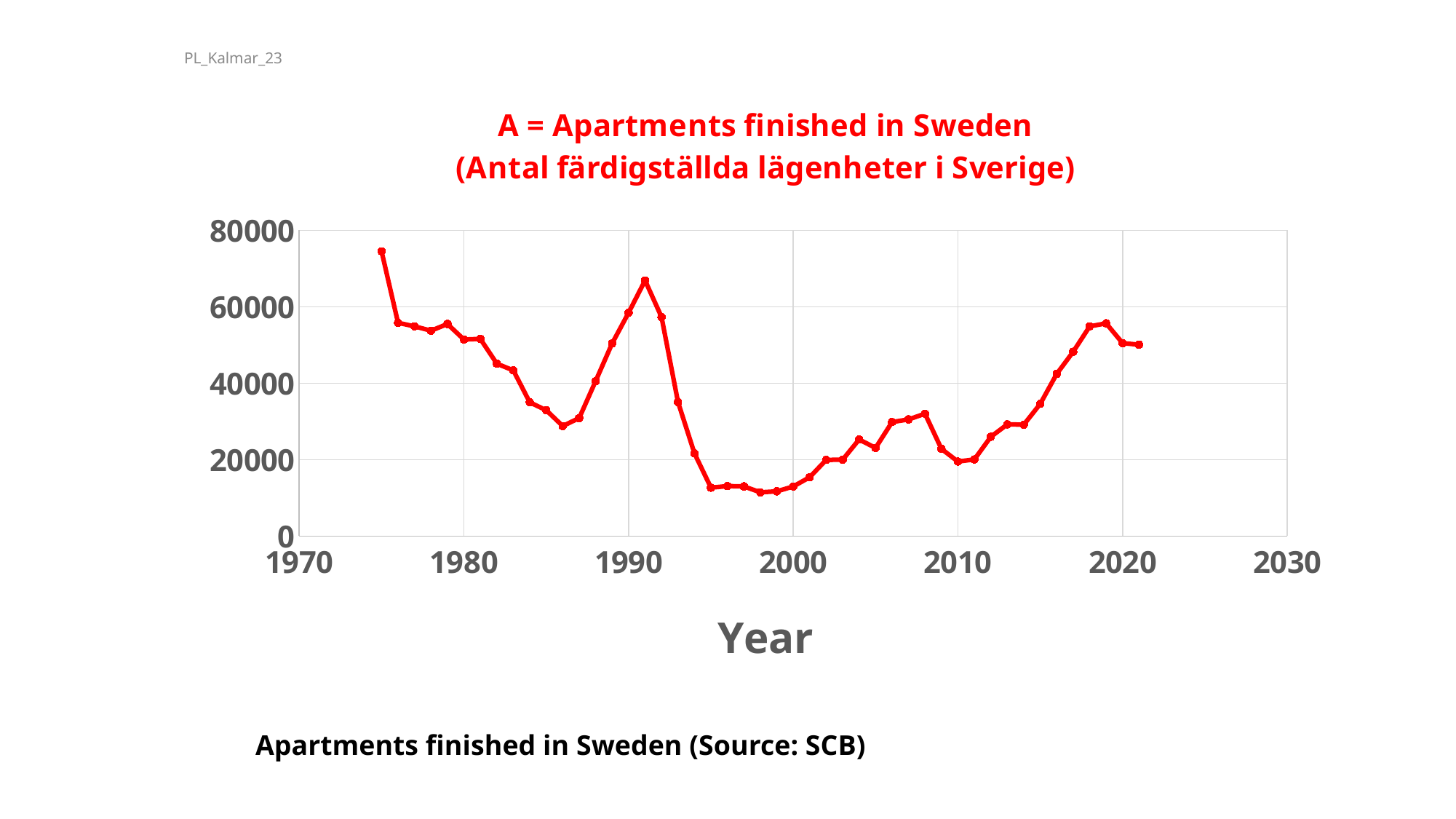
Is the value for 1986 greater or less than 40000? less Which year has the highest number of apartments finished? 1975 What kind of chart is shown on the slide? Line chart Is the value for 1975 greater or less than 60000? greater Is the value for 1991 greater or less than 60000? greater What colour is the plotted line? Red Do the values rise or fall between 2010 and 2019? Rise Which is larger, the value for 1975 or the value for 1991? 1975 What is the label of the x axis? Year